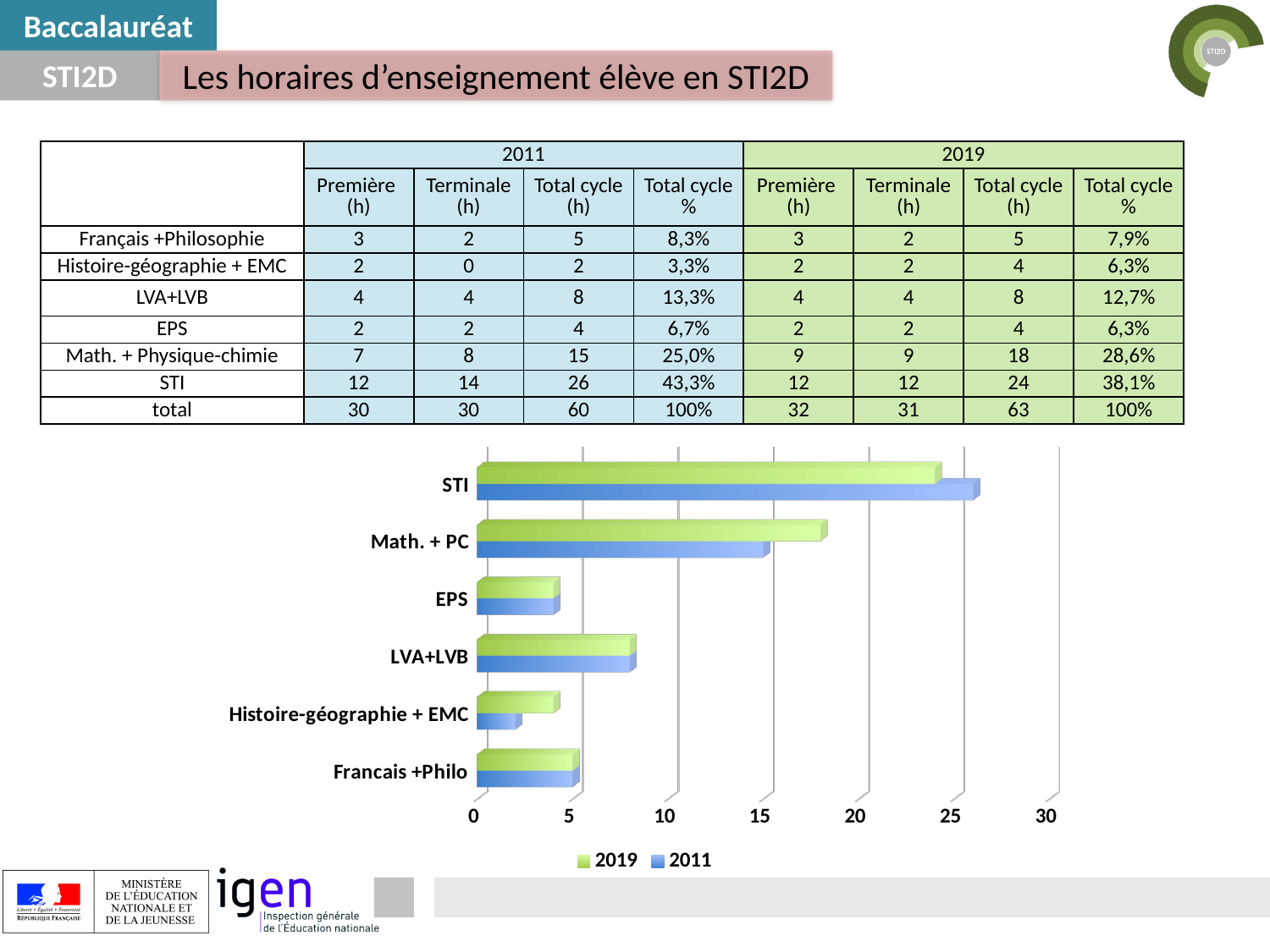
In the chart, is the 2019 bar for Math. + PC greater or less than 15? greater Which category has the longest bar for 2011 in the chart? STI Which colour represents the 2019 series in the chart legend? green What kind of chart is shown on the slide? bar chart Which category has the longest bar for 2019 in the chart? STI How many categories are shown on the chart's vertical axis? 6 In the chart, which is larger for STI: the 2019 bar or the 2011 bar? 2011 In the chart, is the 2019 bar for STI greater or less than 25? less In the chart, which is larger for Histoire-géographie + EMC: the 2019 bar or the 2011 bar? 2019 How many series does the chart legend list? 2 In the chart, is the 2011 bar for STI greater or less than 25? greater Which category has the shortest bar for 2011 in the chart? Histoire-géographie + EMC